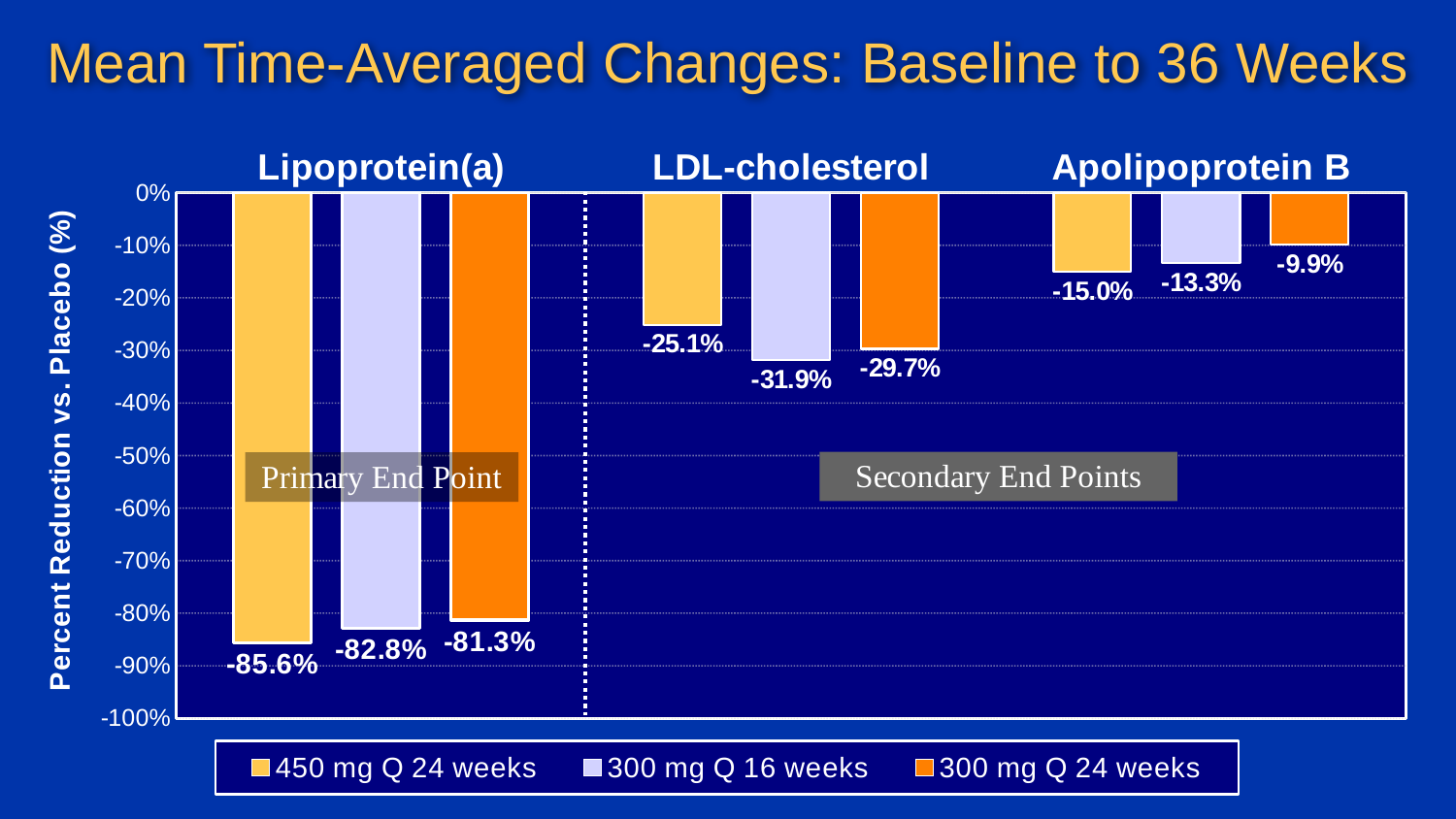
What is the percent reduction vs. placebo in Lipoprotein(a) for the 450 mg Q 24 weeks group? -85.6% How many series does the legend list? 3 What is the percent reduction vs. placebo in Apolipoprotein B for the 300 mg Q 24 weeks group? -9.9% Which dosing group shows the smallest reduction in Apolipoprotein B? 300 mg Q 24 weeks What is the difference in percentage points between the LDL-cholesterol reductions for the 300 mg Q 16 weeks and 450 mg Q 24 weeks groups? 6.8 percentage points How many endpoint categories are shown on the chart? 3 Which dosing group shows the largest reduction in Lipoprotein(a)? 450 mg Q 24 weeks Which endpoint is labelled as the Primary End Point? Lipoprotein(a) Is the reduction in Apolipoprotein B for the 450 mg Q 24 weeks group greater or less than 20%? less What is the percent reduction vs. placebo in LDL-cholesterol for the 300 mg Q 16 weeks group? -31.9% Which group has a larger reduction in LDL-cholesterol: 300 mg Q 16 weeks or 300 mg Q 24 weeks? 300 mg Q 16 weeks What kind of chart is shown on the slide? Bar chart